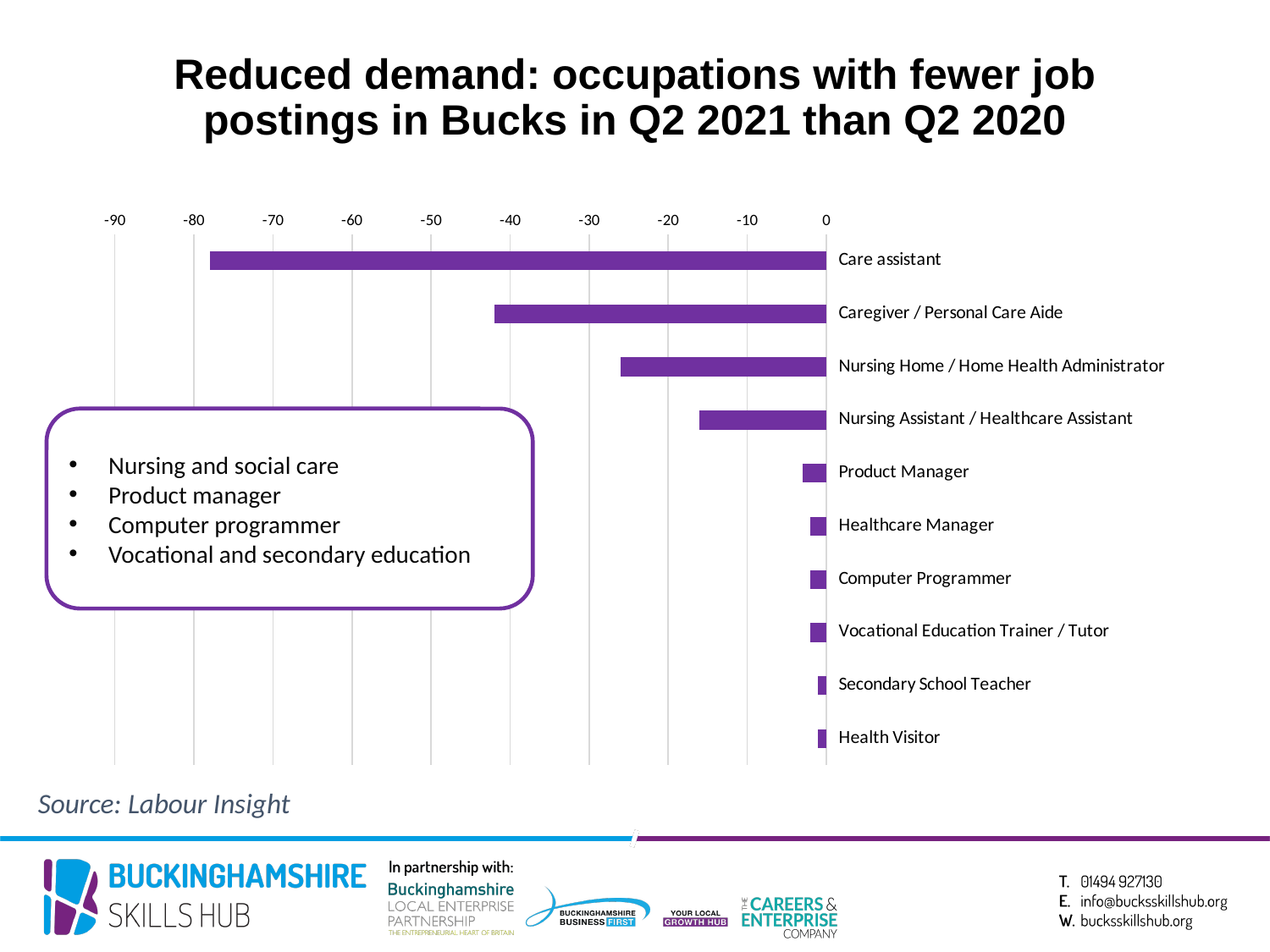
Is the value for Care assistant greater or less than -70? less Which shows a larger decrease in job postings: Care assistant or Caregiver / Personal Care Aide? Care assistant What is the lowest value shown on the chart's horizontal axis? -90 What is the source cited for the chart data? Labour Insight Is the value for Nursing Home / Home Health Administrator greater or less than -30? greater Which shows a larger decrease in job postings: Nursing Home / Home Health Administrator or Nursing Assistant / Healthcare Assistant? Nursing Home / Home Health Administrator Is the value for Caregiver / Personal Care Aide greater or less than -30? less Which occupation shows the largest reduction in job postings? Care assistant How many occupations are plotted in the chart? 10 What kind of chart is shown on the slide? Bar chart